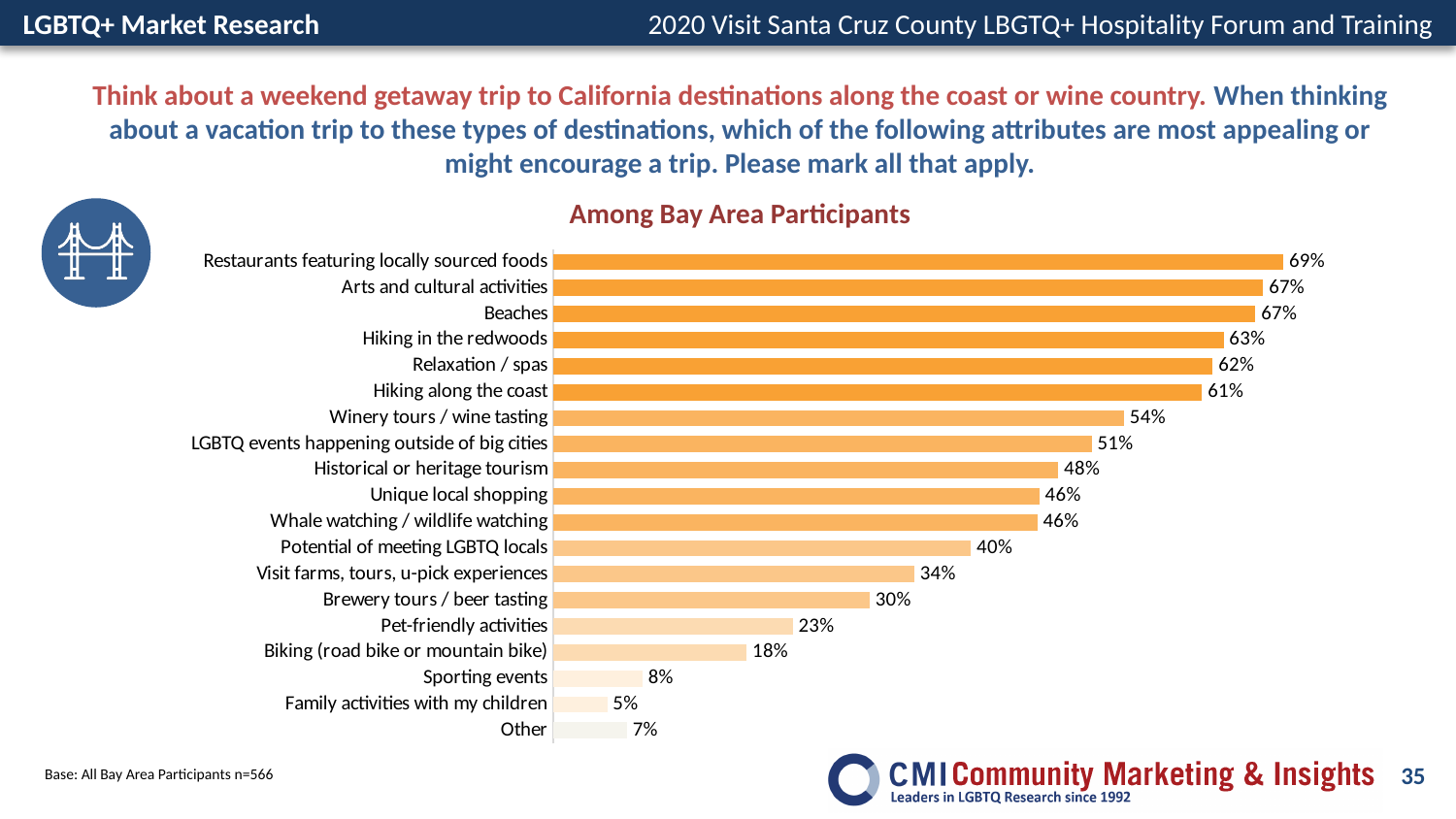
What is the title of the chart? Among Bay Area Participants What is the difference between 'Potential of meeting LGBTQ locals' and 'Pet-friendly activities'? 17% What type of chart is shown on the slide? Bar chart What is the base sample size stated for the chart? n=566 Which attribute has the lowest value on the chart? Family activities with my children Which is larger, 'Hiking in the redwoods' or 'Hiking along the coast'? Hiking in the redwoods What is the difference between 'Beaches' and 'Brewery tours / beer tasting'? 37% What is the value for 'Family activities with my children'? 5% What percentage of Bay Area participants selected 'Restaurants featuring locally sourced foods'? 69% What is the value for 'Winery tours / wine tasting'? 54% Which attribute has the highest value on the chart? Restaurants featuring locally sourced foods How many attributes (categories) are shown on the chart? 19